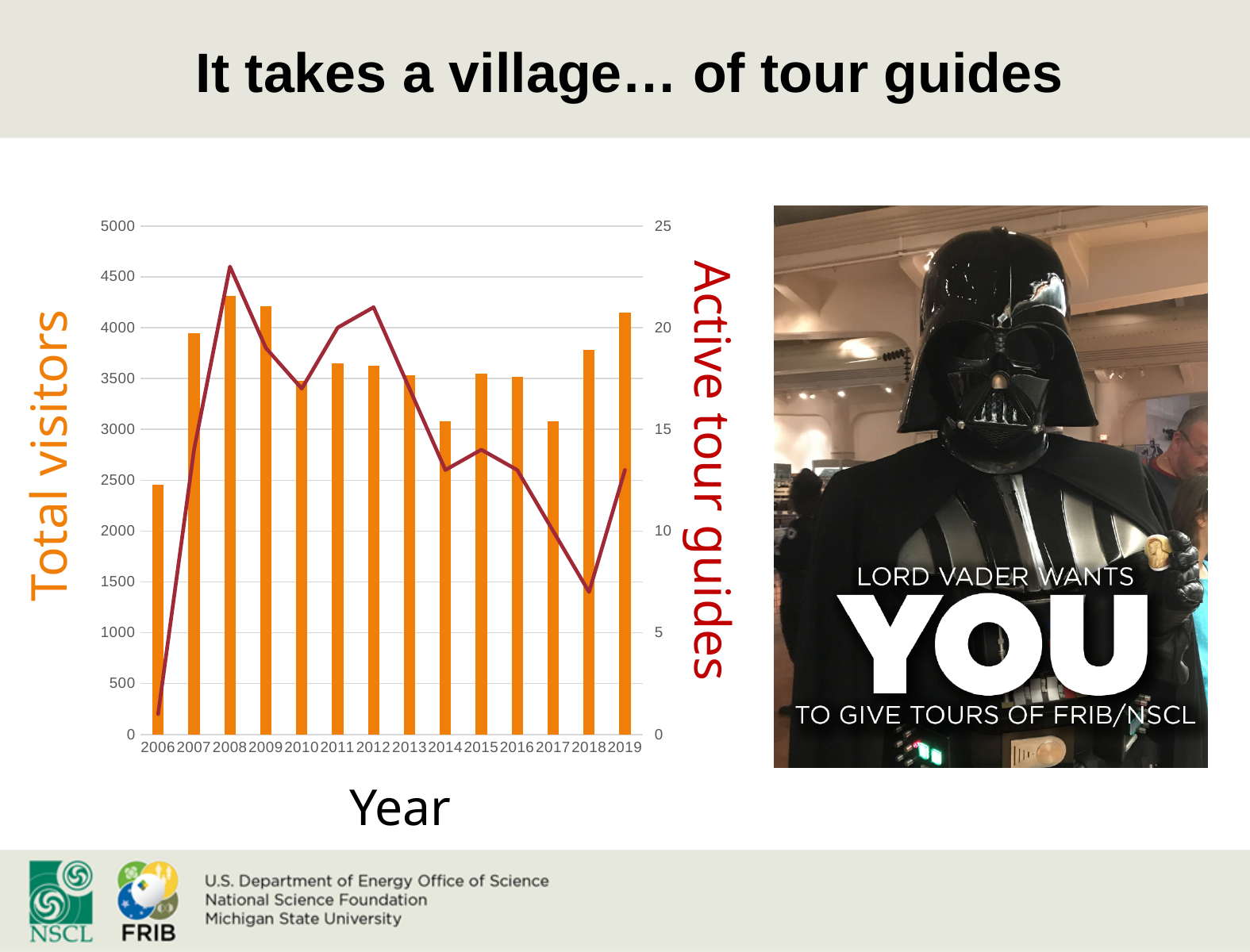
How many years are shown on the x axis of the chart? 14 Is the total visitors value for 2008 greater or less than 4000? greater What is the label on the left vertical axis of the chart? Total visitors Is the active tour guides value for 2008 greater or less than 20? greater In which year does the active tour guides line reach its highest point? 2008 Which year has more total visitors, 2006 or 2007? 2007 Is the total visitors value for 2006 greater or less than 3000? less Which year has the lowest total visitors bar? 2006 Which year has the highest total visitors bar? 2008 In which year does the active tour guides line reach its lowest point? 2006 What kind of chart is shown on the slide? A bar chart combined with a line chart